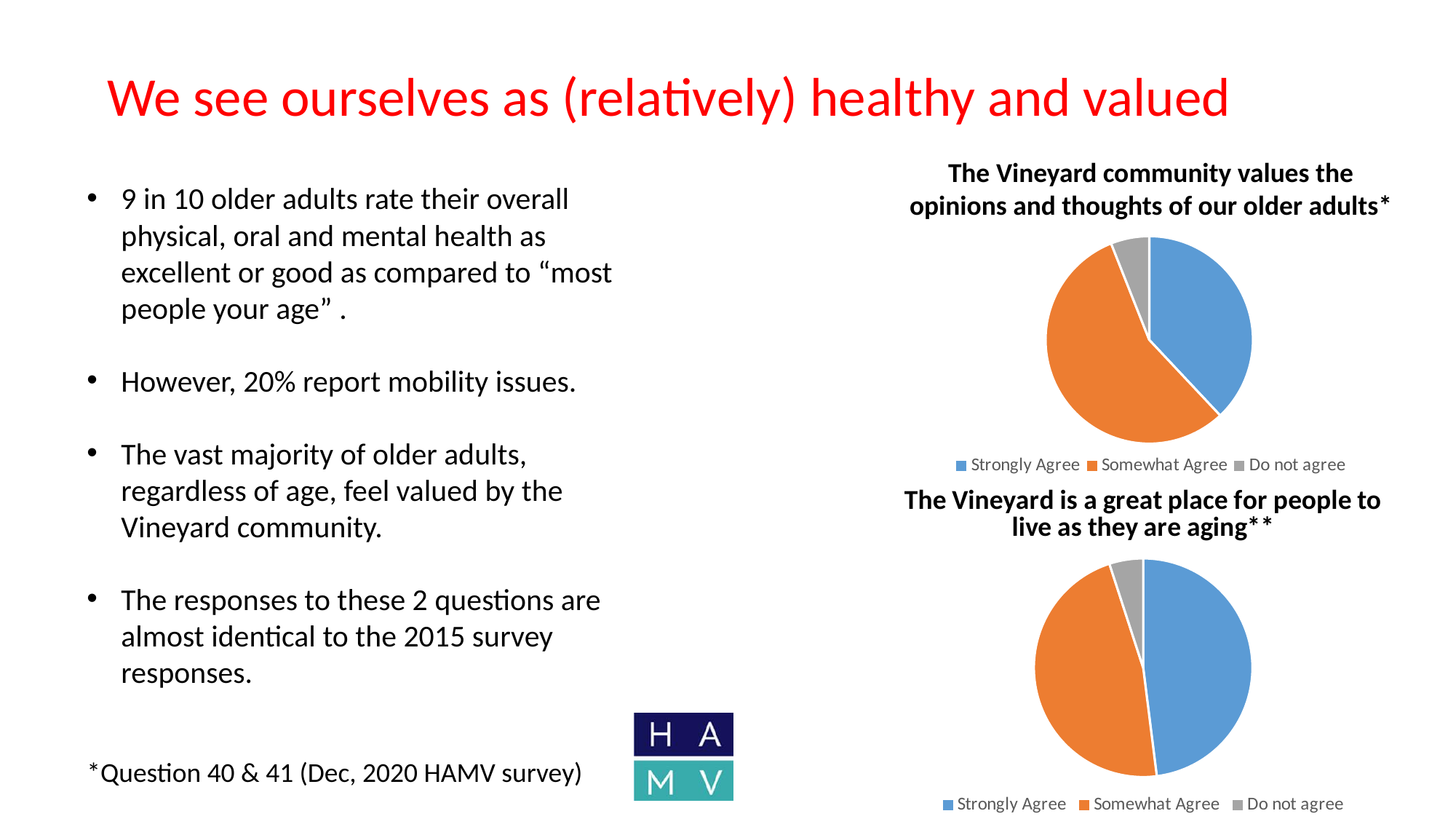
In the chart "The Vineyard community values the opinions and thoughts of our older adults*", which response has the largest slice? Somewhat Agree In the chart "The Vineyard is a great place for people to live as they are aging**", which response has the smallest slice? Do not agree In the chart "The Vineyard is a great place for people to live as they are aging**", how many categories does the legend list? 3 What colour represents "Do not agree" in the pie charts on the slide? grey What kind of chart is "The Vineyard community values the opinions and thoughts of our older adults*"? pie chart What kind of chart is "The Vineyard is a great place for people to live as they are aging**"? pie chart In the chart "The Vineyard community values the opinions and thoughts of our older adults*", which slice is larger: Somewhat Agree or Do not agree? Somewhat Agree What is the title of the lower pie chart on the slide? The Vineyard is a great place for people to live as they are aging** In the chart "The Vineyard is a great place for people to live as they are aging**", which slice is larger: Strongly Agree or Do not agree? Strongly Agree In the chart "The Vineyard community values the opinions and thoughts of our older adults*", which response has the smallest slice? Do not agree In the chart "The Vineyard community values the opinions and thoughts of our older adults*", which slice is larger: Strongly Agree or Somewhat Agree? Somewhat Agree In the chart "The Vineyard community values the opinions and thoughts of our older adults*", how many slices does the pie have? 3